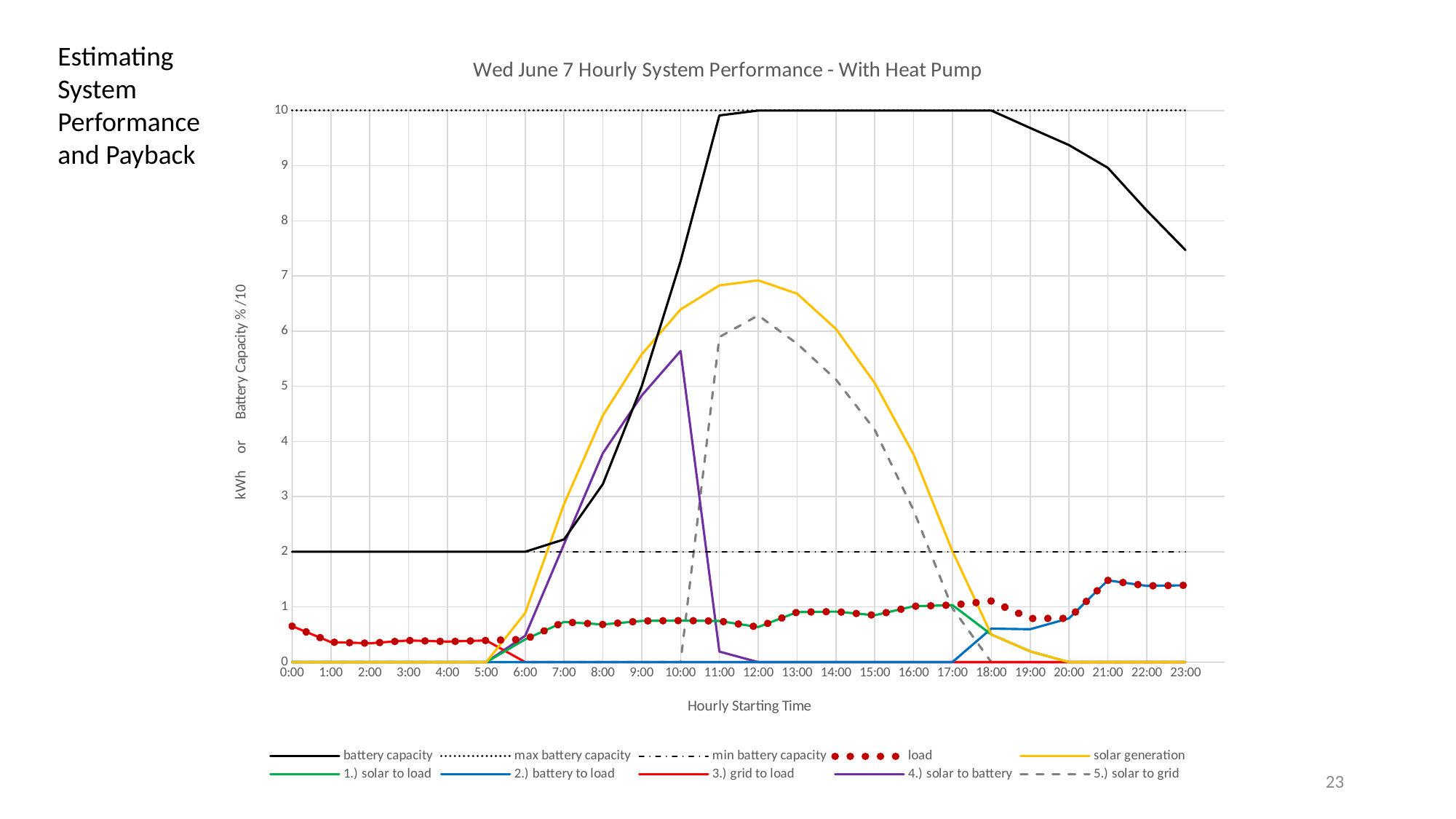
Is the solar generation value at 12:00 greater or less than 6? greater At which hour does solar generation reach its highest value? 12:00 What is the title of the chart? Wed June 7 Hourly System Performance - With Heat Pump What kind of chart is shown on the slide? line chart At 10:00, which is larger: solar generation or load? solar generation How many series does the legend list? 10 What value does the max battery capacity line sit at? 10 Is the battery capacity value at 23:00 greater or less than 8? less Is the solar to battery value at 10:00 greater or less than 5? greater How many hourly time points are plotted along the x axis? 24 What value does the min battery capacity line sit at? 2 Does battery capacity rise or fall from 18:00 to 23:00? fall